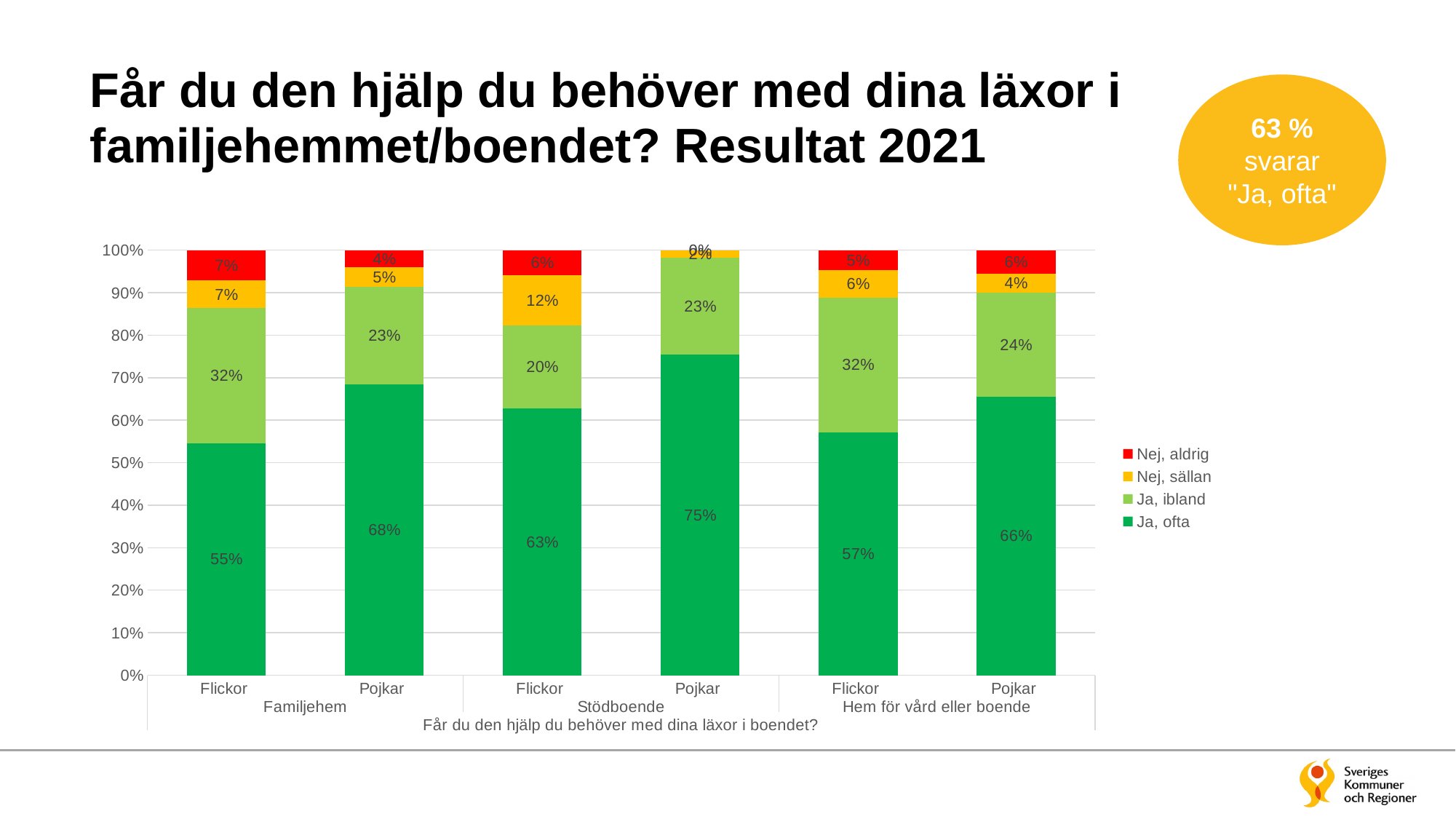
What kind of chart is shown on the slide? Stacked bar chart Which is larger: the "Ja, ibland" value for Flickor in Hem för vård eller boende or for Pojkar in Hem för vård eller boende? Flickor Which legend entry is shown in red? Nej, aldrig Which bar has the highest "Ja, ofta" value? Pojkar, Stödboende How many bars are plotted in the chart? 6 What is the difference between the "Ja, ofta" values for Pojkar and Flickor in Familjehem? 13% What is the "Ja, ibland" value for Flickor in Familjehem? 32% How many series does the legend list? 4 What is the "Nej, sällan" value for Flickor in Stödboende? 12% Which bar has the lowest "Ja, ofta" value? Flickor, Familjehem What is the "Ja, ofta" value for Pojkar in Stödboende? 75% What is the "Nej, aldrig" value for Pojkar in Hem för vård eller boende? 6%